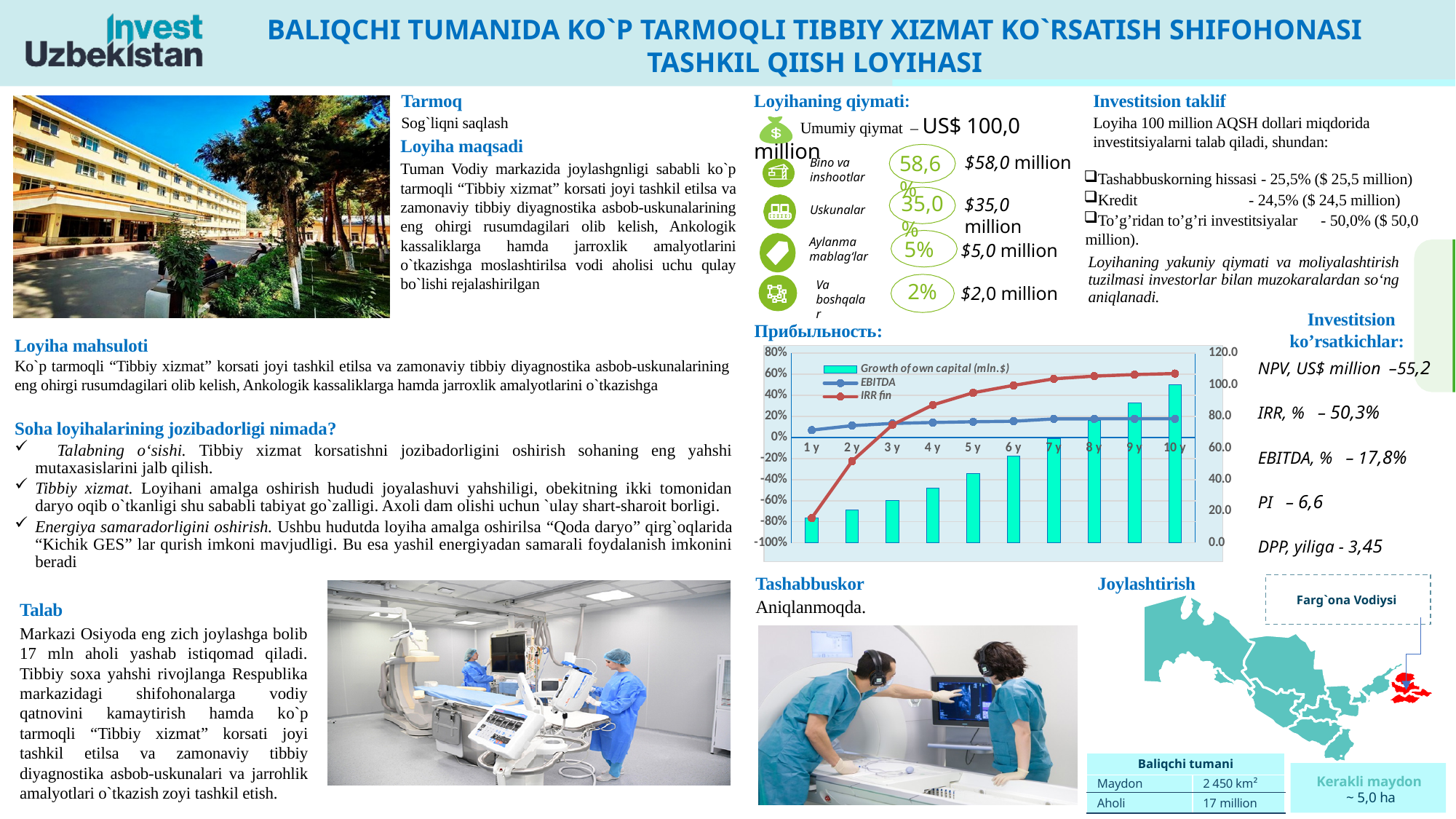
What kind of chart is shown under the heading "Прибыльность:"? A bar chart combined with line series In the "Прибыльность:" chart, in which year is the IRR fin value highest? 10 y In the "Прибыльность:" chart, is the IRR fin value at 1 y greater or less than -60%? less In the "Прибыльность:" chart, in which year is the IRR fin value lowest? 1 y Does the IRR fin line in the "Прибыльность:" chart rise or fall from 1 y to 10 y? Rise How many series does the legend of the "Прибыльность:" chart list? 3 In the "Прибыльность:" chart, is the IRR fin value at 10 y greater or less than 40%? greater Which series in the "Прибыльность:" chart is drawn as bars? Growth of own capital (mln.$) How many year categories are shown on the x axis of the "Прибыльность:" chart? 10 In the "Прибыльность:" chart, which is larger at 10 y: the IRR fin value or the EBITDA value? IRR fin Do the Growth of own capital bars in the "Прибыльность:" chart rise or fall from 1 y to 10 y? Rise In the "Прибыльность:" chart, which is larger at 1 y: the EBITDA value or the IRR fin value? EBITDA